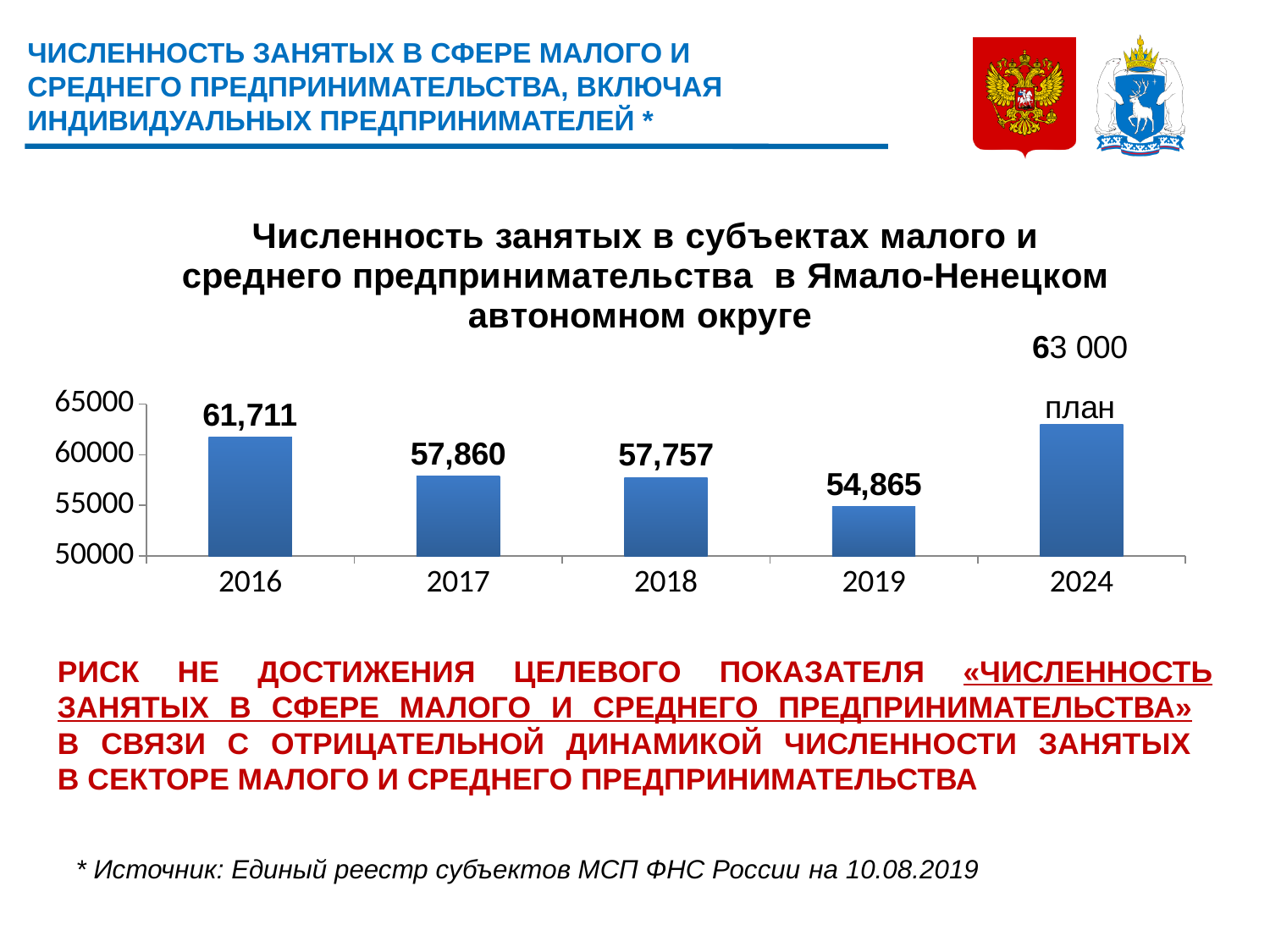
What is the number of people employed in small and medium enterprises in 2016? 61,711 What type of chart is shown on the slide? bar chart Which is larger, the value for 2016 or the value for 2019? 2016 What is the value shown for 2017? 57,860 What is the planned value shown for 2024? 63 000 How many years are shown on the x axis of the chart? 5 Is the value for 2019 greater or less than 55000? less What is the difference between the values for 2016 and 2017? 3,851 Which year has the lowest value on the chart? 2019 What is the difference between the values for 2018 and 2019? 2,892 What is the value shown for 2019? 54,865 Among the years 2016 to 2019, which year has the highest value? 2016